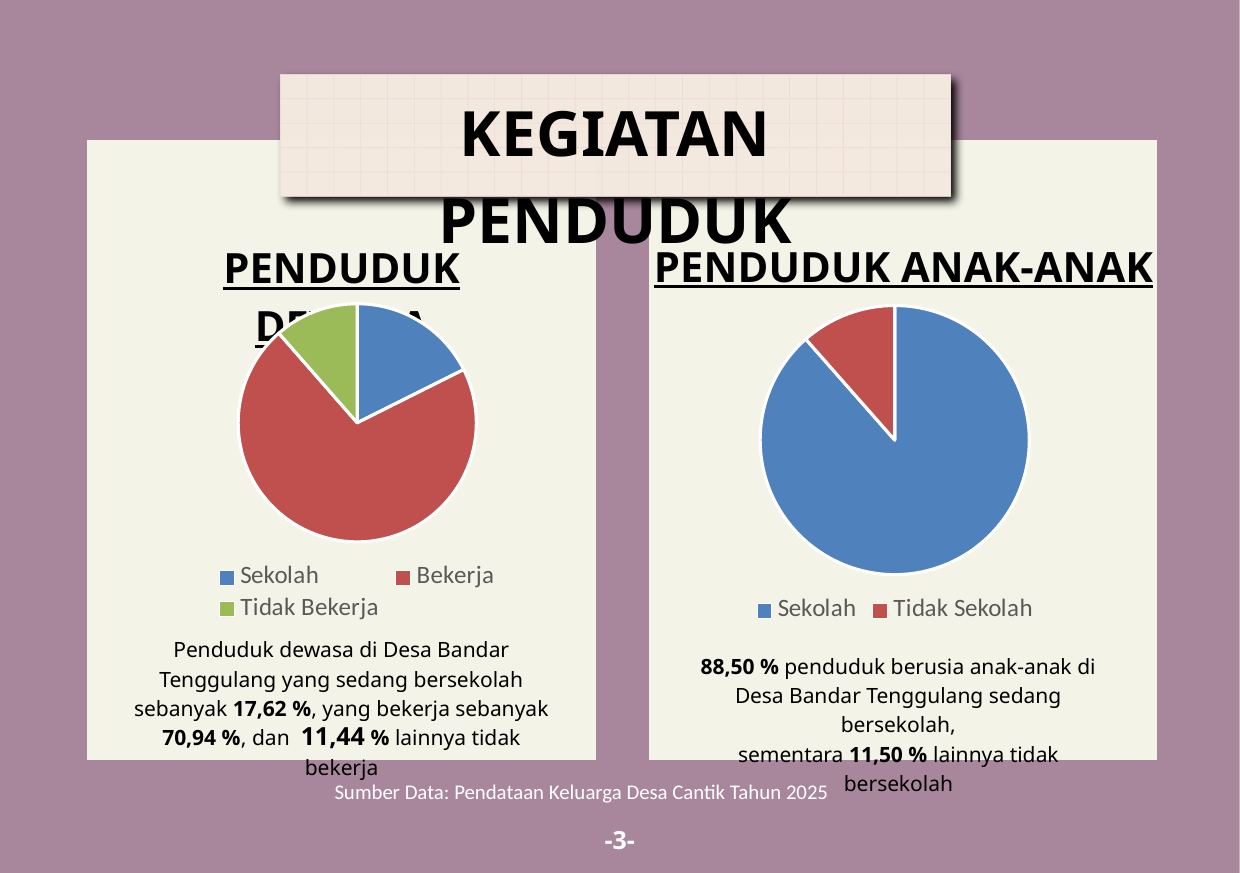
How many slices does the PENDUDUK ANAK-ANAK pie chart have? 2 According to the slide, what share of the PENDUDUK ANAK-ANAK chart is Tidak Sekolah? 11,50 % What kind of chart is the chart titled PENDUDUK ANAK-ANAK? pie chart What kind of chart is the left chart on the slide? pie chart How many entries does the legend of the left pie chart list? 3 In the PENDUDUK ANAK-ANAK chart, what colour is the Sekolah slice? blue In the left pie chart, which category has the largest slice? Bekerja How many entries does the legend of the PENDUDUK ANAK-ANAK chart list? 2 According to the slide, what share of the left pie chart is Bekerja? 70,94 % In the left pie chart, which category has the smallest slice? Tidak Bekerja How many slices does the left pie chart have? 3 In the PENDUDUK ANAK-ANAK chart, which category has the larger slice? Sekolah